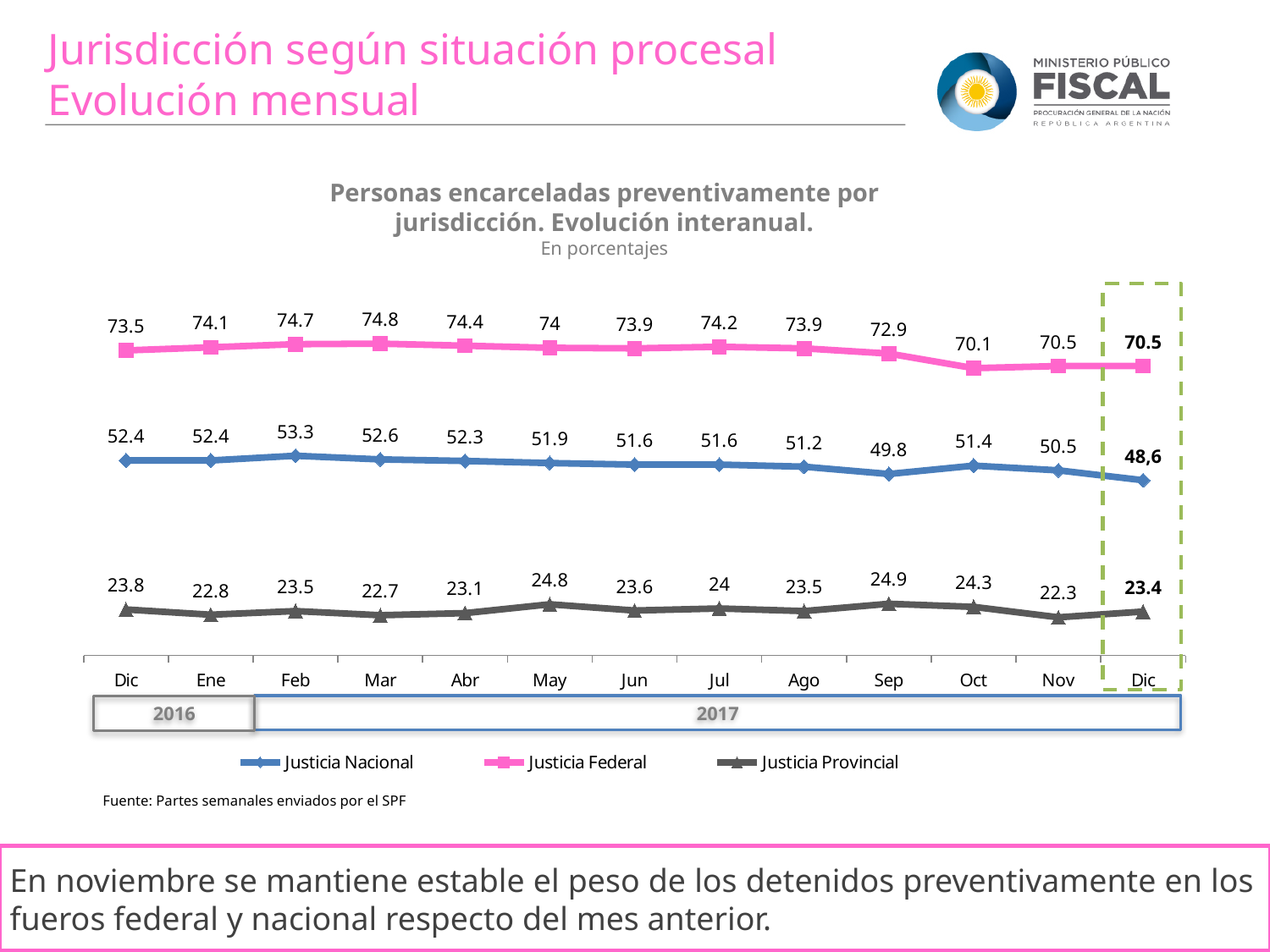
Does the Justicia Federal series generally rise or fall from Dic 2016 to Dic 2017? Fall Which is larger in Oct: Justicia Nacional or Justicia Provincial? Justicia Nacional How many months are plotted on the x axis? 13 What is the difference between the Justicia Federal values in Dic 2016 and Dic 2017? 3 How many series does the legend list? 3 In which month does Justicia Provincial have its lowest value? Nov What kind of chart is shown on the slide? Line chart What is the value for Justicia Nacional in Dic 2017 (the last point)? 48,6 In which month does Justicia Federal reach its highest value? Mar What is the value for Justicia Federal in Mar? 74.8 What is the value for Justicia Provincial in Sep? 24.9 Which series is drawn in pink? Justicia Federal